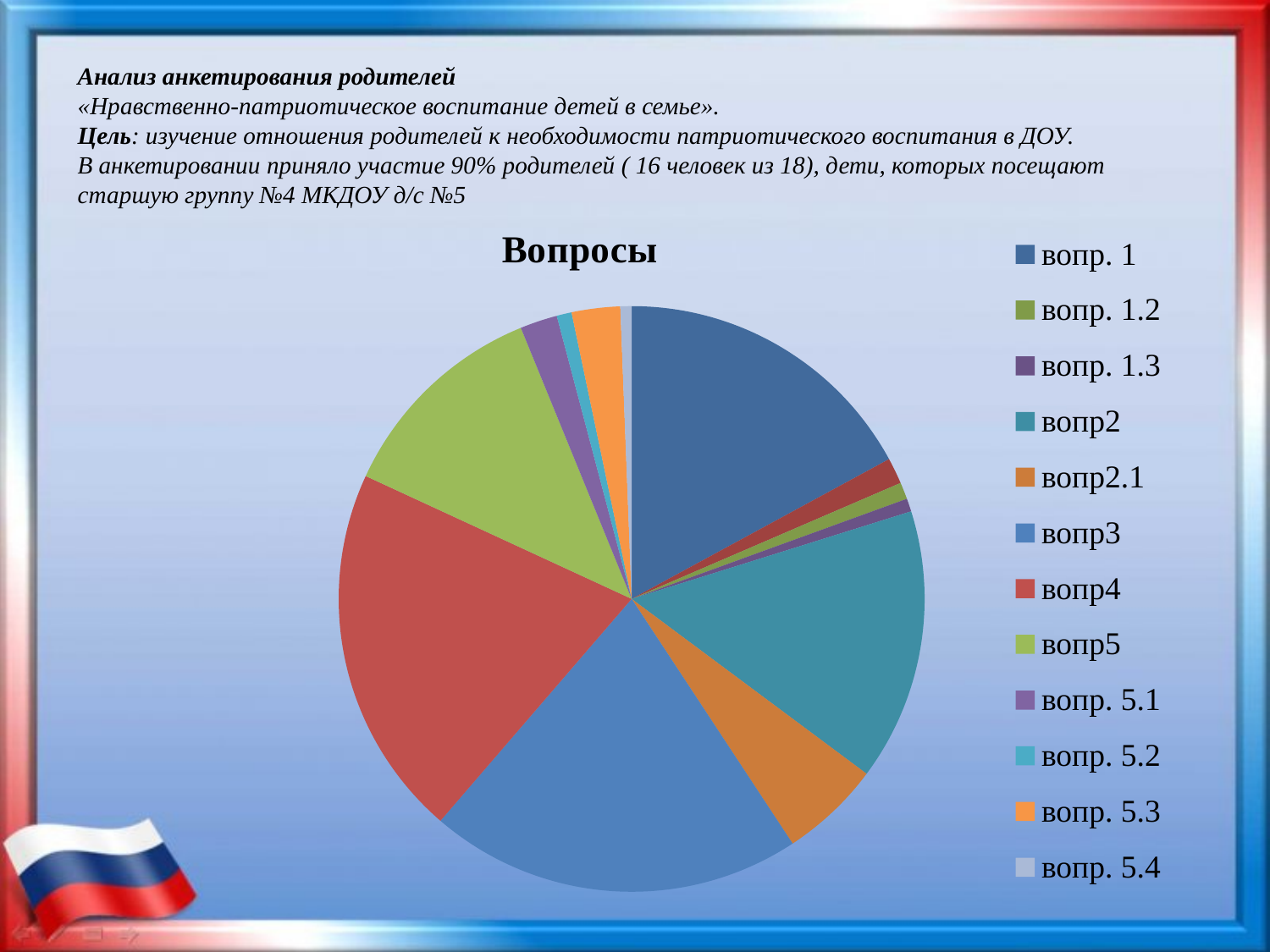
Which slice is larger, вопр. 1 or вопр. 5.3? вопр. 1 How many entries does the chart legend list? 12 Which slice is larger, вопр5 or вопр. 5.2? вопр5 What colour is the legend entry for вопр. 5.3? orange What is the title of the chart? Вопросы Which slice is larger, вопр3 or вопр2.1? вопр3 What kind of chart is shown on the slide? pie chart